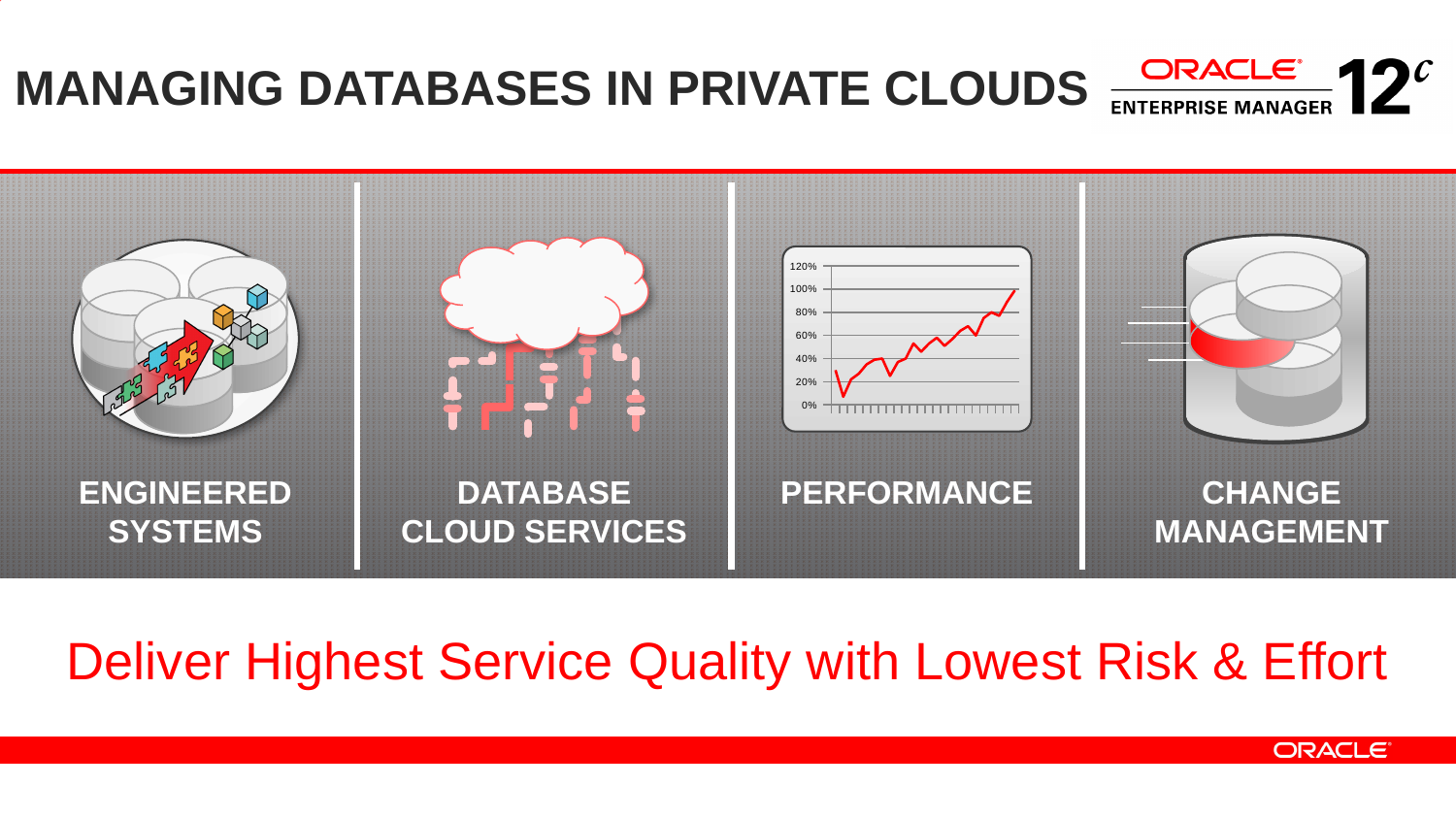
In the PERFORMANCE chart, is the last (rightmost) point of the line greater or less than 80%? greater In the PERFORMANCE chart, is the lowest point of the line greater or less than 20%? less In the PERFORMANCE chart, is the first (leftmost) point of the line greater or less than 60%? less In the PERFORMANCE chart, which is larger: the value at the right end of the line or the value at the left end? the right end What is the lowest value labelled on the y axis of the PERFORMANCE chart? 0% In the PERFORMANCE line chart, do the values generally rise or fall from left to right? rise How many lines (series) are plotted in the PERFORMANCE chart? 1 What kind of chart is shown in the PERFORMANCE panel? line chart What is the highest value labelled on the y axis of the PERFORMANCE chart? 120%